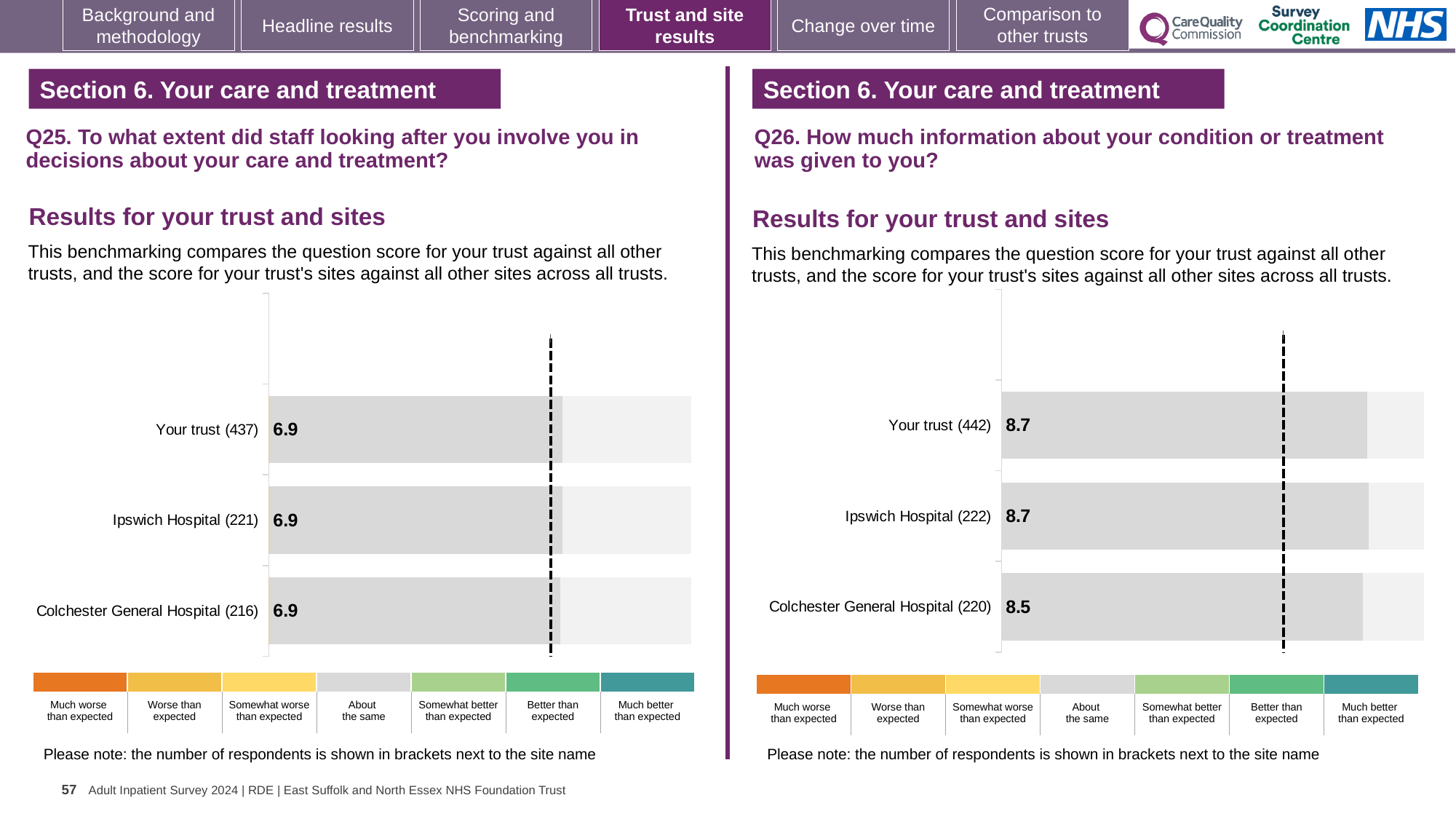
In the Q25 chart on the left, what is the score for Your trust (437)? 6.9 In the Q25 chart on the left, what is the score for Colchester General Hospital (216)? 6.9 What type of chart is used for the Q26 results on the right? Bar chart How many bars are shown in the Q25 chart on the left? 3 In the Q26 chart on the right, what is the score for Colchester General Hospital (220)? 8.5 How many respondents are shown in brackets for Ipswich Hospital in the Q25 chart on the left? 221 In the Q26 chart on the right, what is the score for Your trust (442)? 8.7 In the Q25 chart on the left, do the scores for Your trust, Ipswich Hospital and Colchester General Hospital differ from each other? No, all are 6.9 In the Q26 chart on the right, what is the difference between the scores for Ipswich Hospital (222) and Colchester General Hospital (220)? 0.2 In the Q26 chart on the right, which site has the lowest score? Colchester General Hospital (220) In the Q26 chart on the right, what is the score for Ipswich Hospital (222)? 8.7 In the Q26 chart on the right, which has the larger score, Ipswich Hospital (222) or Colchester General Hospital (220)? Ipswich Hospital (222)